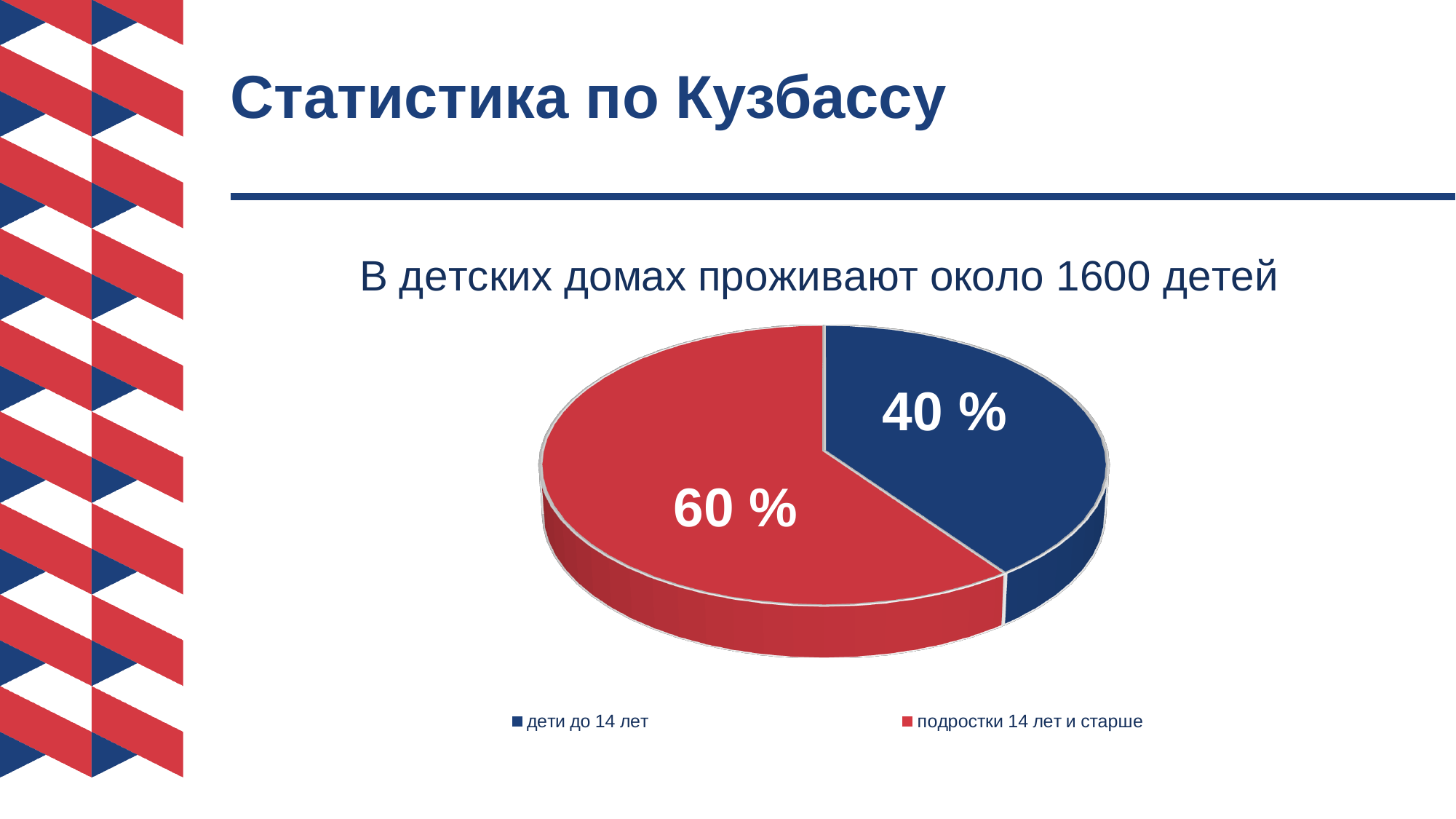
What kind of chart is shown on the slide? pie chart How many entries does the legend list? 2 Which category has the largest slice of the pie? подростки 14 лет и старше What is the difference in percentage points between the slice for "подростки 14 лет и старше" and the slice for "дети до 14 лет"? 20 % Which category has the smallest slice of the pie? дети до 14 лет How many slices does the pie chart have? 2 What share of the pie is labelled for "подростки 14 лет и старше"? 60 % What is the title of the slide containing the chart? Статистика по Кузбассу What colour is the slice for "дети до 14 лет"? blue What share of the pie is labelled for "дети до 14 лет"? 40 % Which slice is larger: "дети до 14 лет" or "подростки 14 лет и старше"? подростки 14 лет и старше